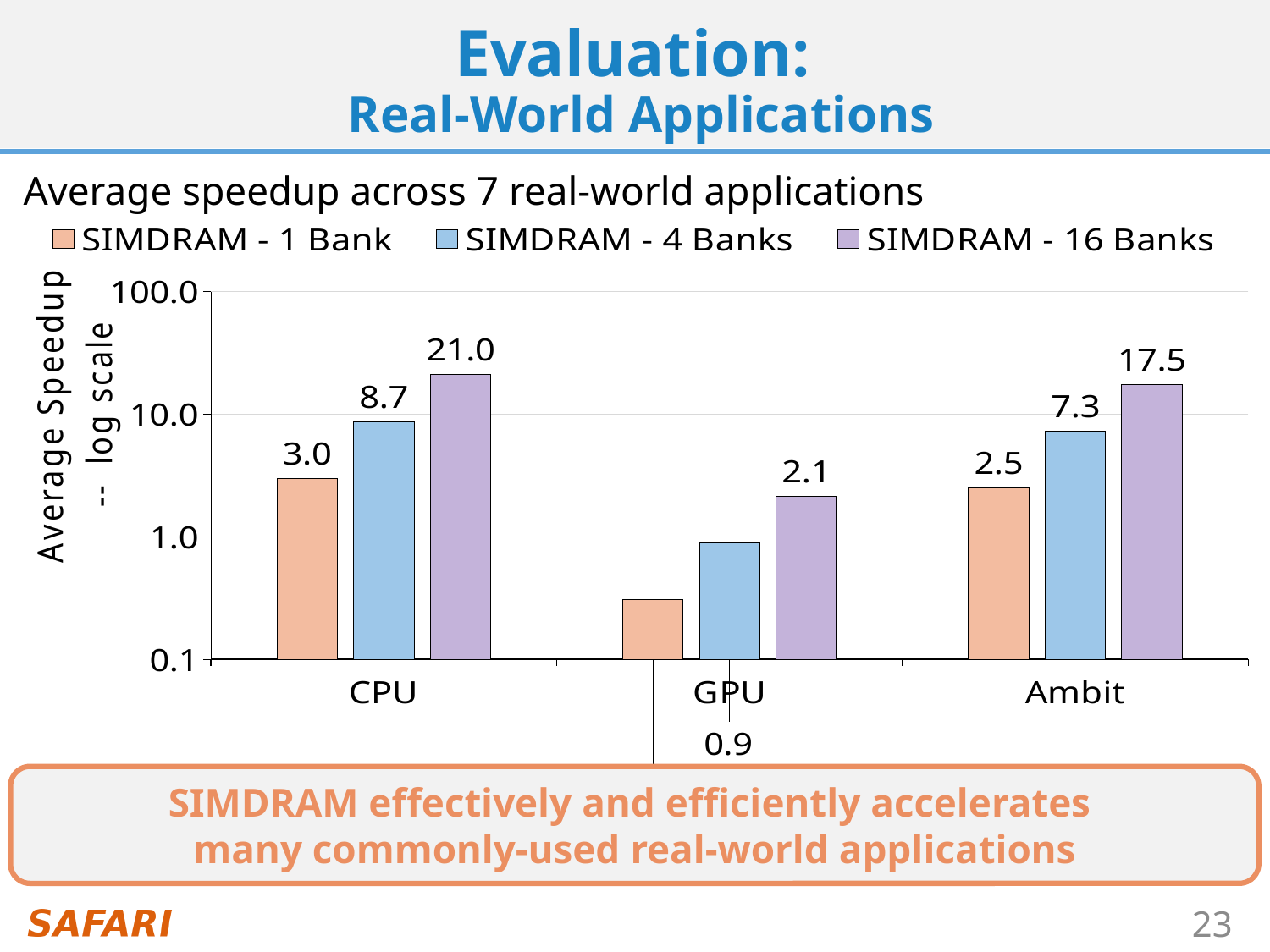
Is the value for SIMDRAM - 1 Bank for GPU greater or less than 1.0? less What type of chart is shown on the slide? bar chart What is the difference between the SIMDRAM - 16 Banks values for CPU and Ambit? 3.5 How many categories are shown on the x axis? 3 How many series does the legend list? 3 What is the average speedup of SIMDRAM - 4 Banks for GPU? 0.9 Which category has the lowest value for SIMDRAM - 1 Bank? GPU Which is larger for Ambit: SIMDRAM - 1 Bank or SIMDRAM - 4 Banks? SIMDRAM - 4 Banks What is the average speedup of SIMDRAM - 1 Bank for CPU? 3.0 What is the average speedup of SIMDRAM - 16 Banks for CPU? 21.0 What is the average speedup of SIMDRAM - 4 Banks for Ambit? 7.3 Which category has the highest value for SIMDRAM - 16 Banks? CPU